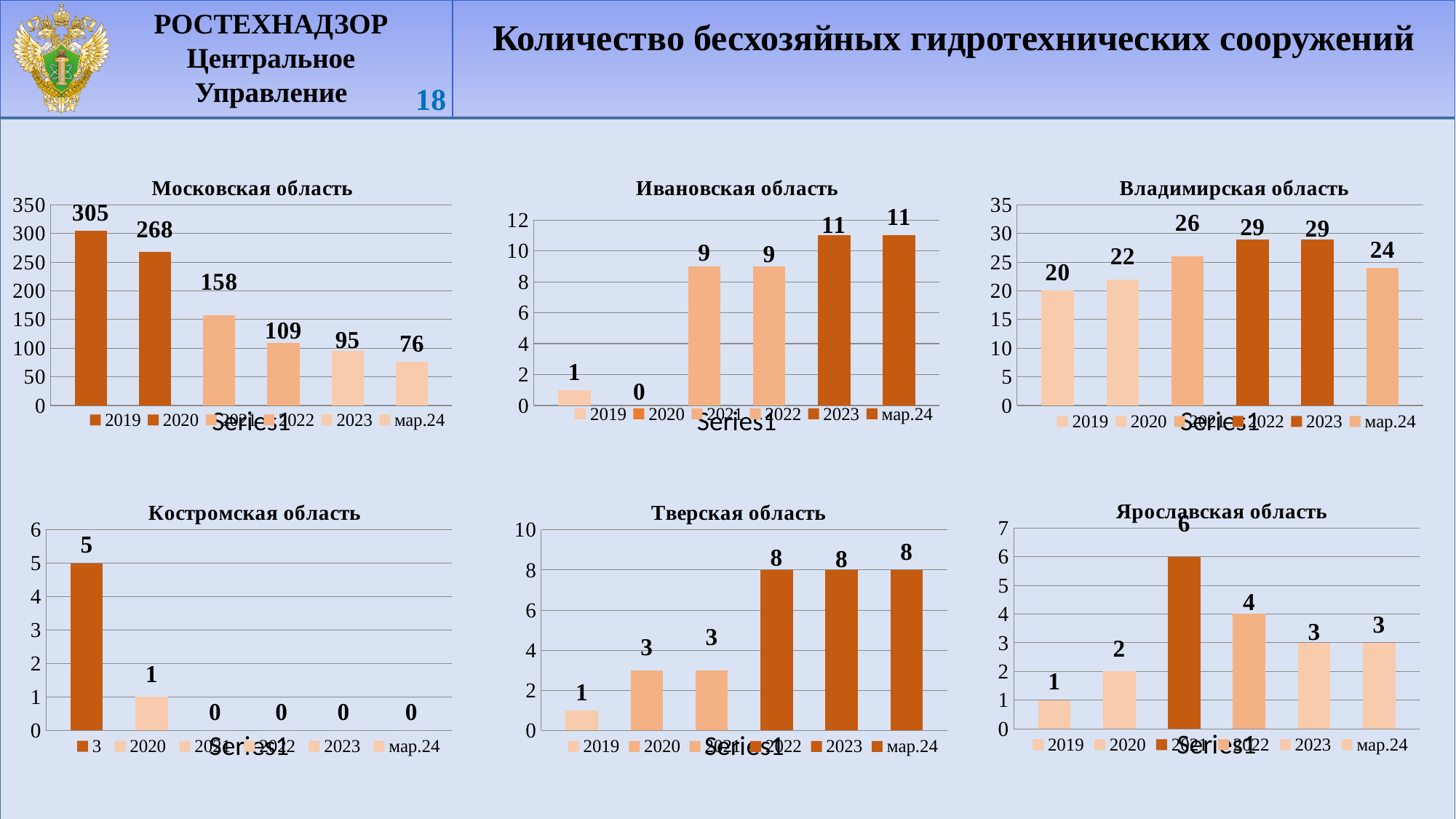
In the Владимирская область chart, which is larger, the value for 2019 or the value for мар.24? мар.24 In the Московская область chart, do the values rise or fall from 2019 to мар.24? fall In the Тверская область chart, what is the value for 2022? 8 How many charts are on the slide? 6 In the Ивановская область chart, what is the value for 2020? 0 In the Московская область chart, what is the difference between the 2019 and 2020 values? 37 In the Ярославская область chart, which year has the highest value? 2021 In the Владимирская область chart, what is the value for 2021? 26 In the Костромская область chart, what is the highest value shown? 5 In the Ивановская область chart, which year has the lowest value? 2020 In the Московская область chart, what is the value for 2019? 305 In the Московская область chart, what is the value for мар.24? 76